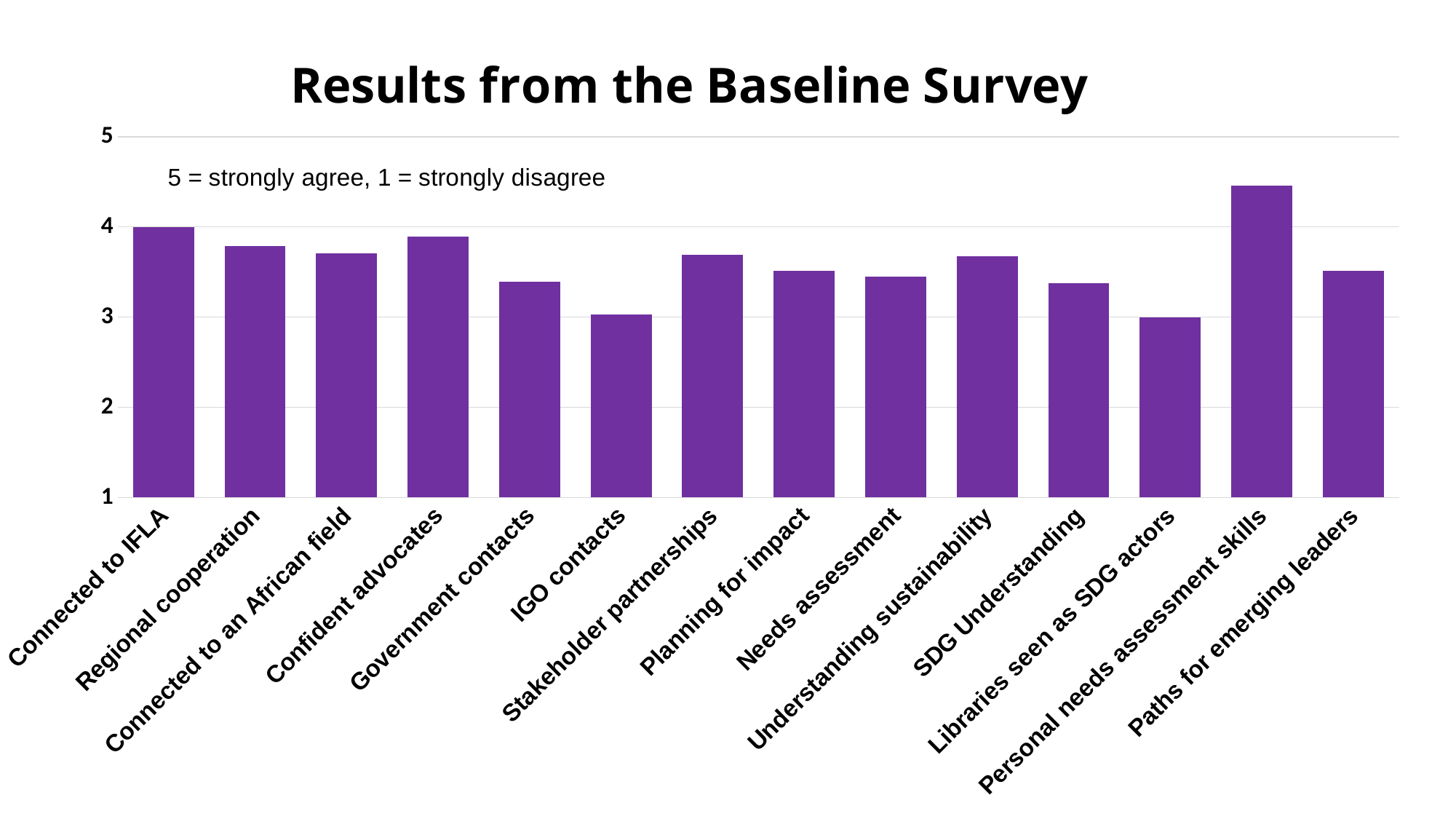
Is the value for Government contacts greater or less than 4? less What kind of chart is shown on the slide? bar chart Is the value for Regional cooperation greater or less than 3? greater Is the value for Personal needs assessment skills greater or less than 4? greater What is the title of the chart? Results from the Baseline Survey Which is larger, the value for Confident advocates or the value for Government contacts? Confident advocates Which is larger, the value for Personal needs assessment skills or the value for Paths for emerging leaders? Personal needs assessment skills Which is larger, the value for Connected to IFLA or the value for IGO contacts? Connected to IFLA Which category has the highest value in the chart? Personal needs assessment skills How many categories are shown on the x axis of the chart? 14 According to the note on the chart, what does a score of 5 mean? strongly agree